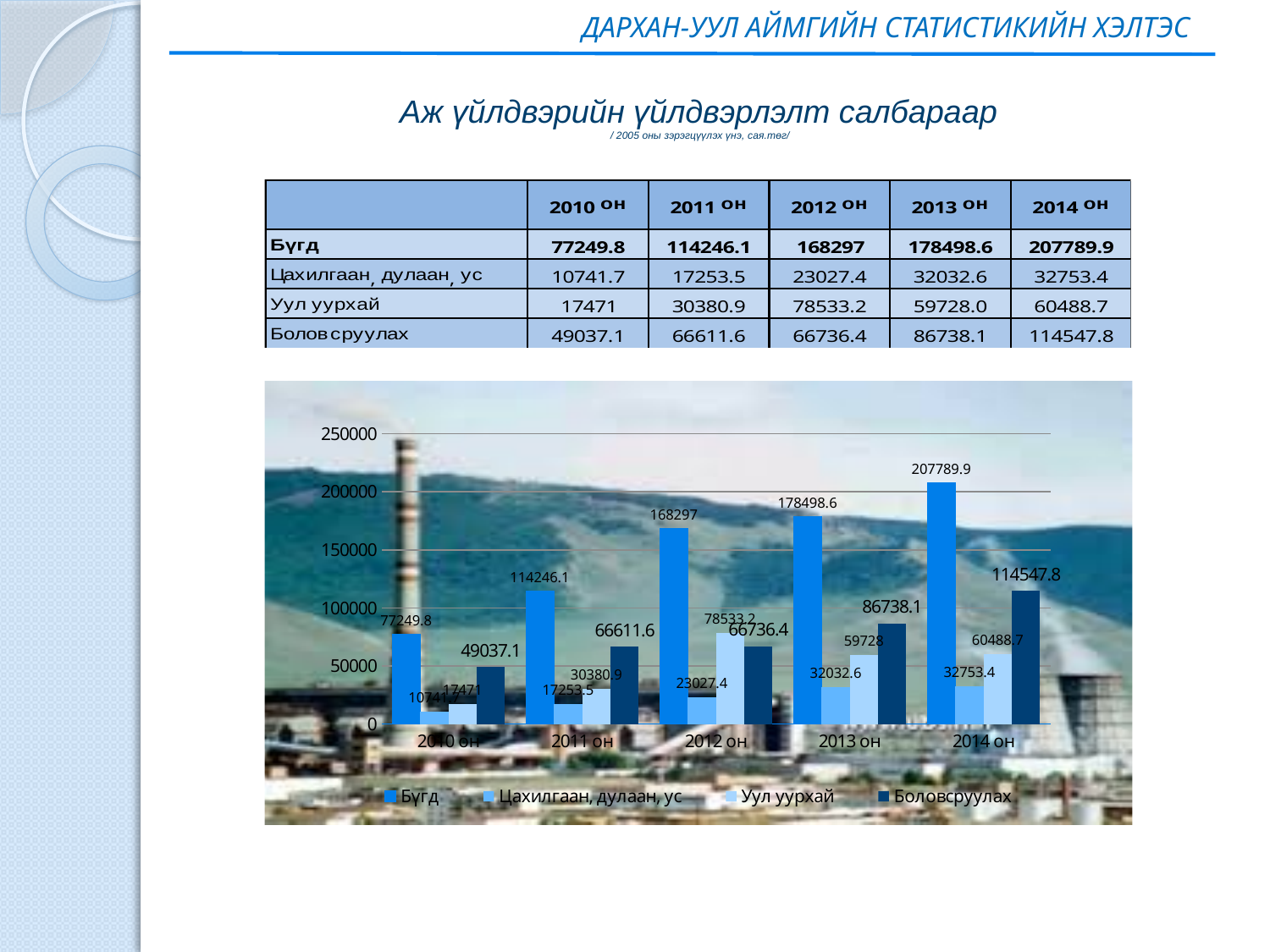
What is the value of Бүгд for 2014 он in the chart? 207789.9 What is the value of Уул уурхай for 2012 он in the chart? 78533.2 What type of chart is shown on the slide? bar chart What is the difference between the Бүгд values for 2014 он and 2013 он? 29291.3 How many series does the chart legend list? 4 How many years are shown on the x axis of the chart? 5 In which year is the Бүгд value highest in the chart? 2014 он Which is larger in 2012 он: Уул уурхай or Боловсруулах? Уул уурхай What is the value of Боловсруулах for 2013 он in the chart? 86738.1 What is the value of Цахилгаан, дулаан, ус for 2011 он in the chart? 17253.5 Does the Бүгд value rise or fall from 2010 он to 2014 он in the chart? rise In which year is the Боловсруулах value lowest in the chart? 2010 он